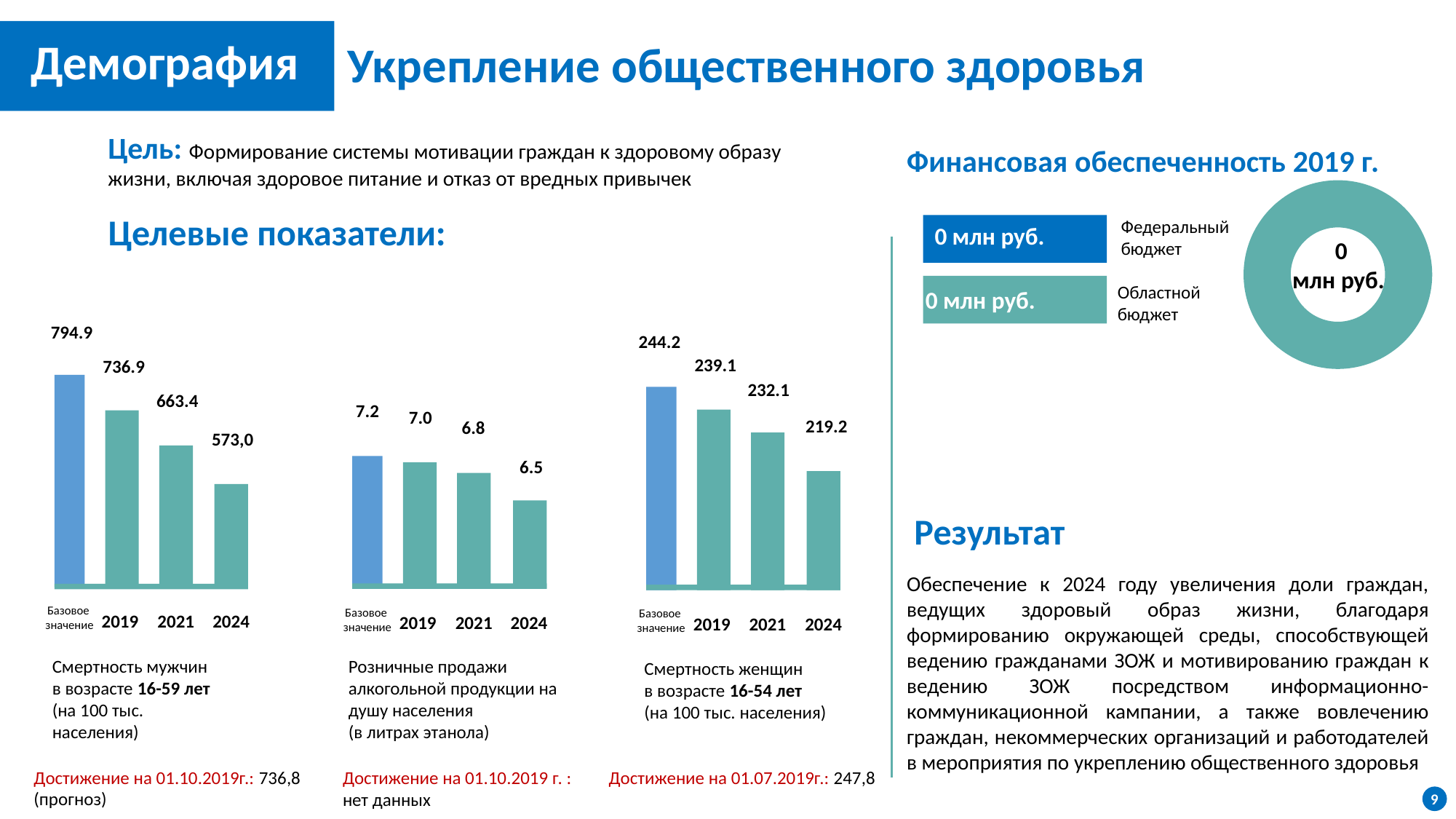
In the left chart (male mortality aged 16-59), what is the value for 2019? 736.9 In the right chart (female mortality aged 16-54), which is larger: the value for 2019 or the value for 2021? 2019 What type of chart is used under the heading 'Финансовая обеспеченность 2019 г.'? Donut (pie) chart In the middle chart (retail alcohol sales per capita), do the values rise or fall from the base value to 2024? fall How many bars are in the left chart (male mortality aged 16-59)? 4 In the right chart (female mortality aged 16-54), what is the difference between the 2019 and 2024 values? 19.9 In the left chart (male mortality aged 16-59), what is the base value (Базовое значение)? 794.9 In the middle chart (retail alcohol sales per capita), which category has the highest value? Базовое значение In the middle chart (retail alcohol sales per capita), what is the value for 2024? 6.5 In the left chart (male mortality aged 16-59), which category has the lowest value? 2024 In the left chart (male mortality aged 16-59), what is the difference between the base value and the 2021 value? 131.5 In the right chart (female mortality aged 16-54), what is the value for 2021? 232.1